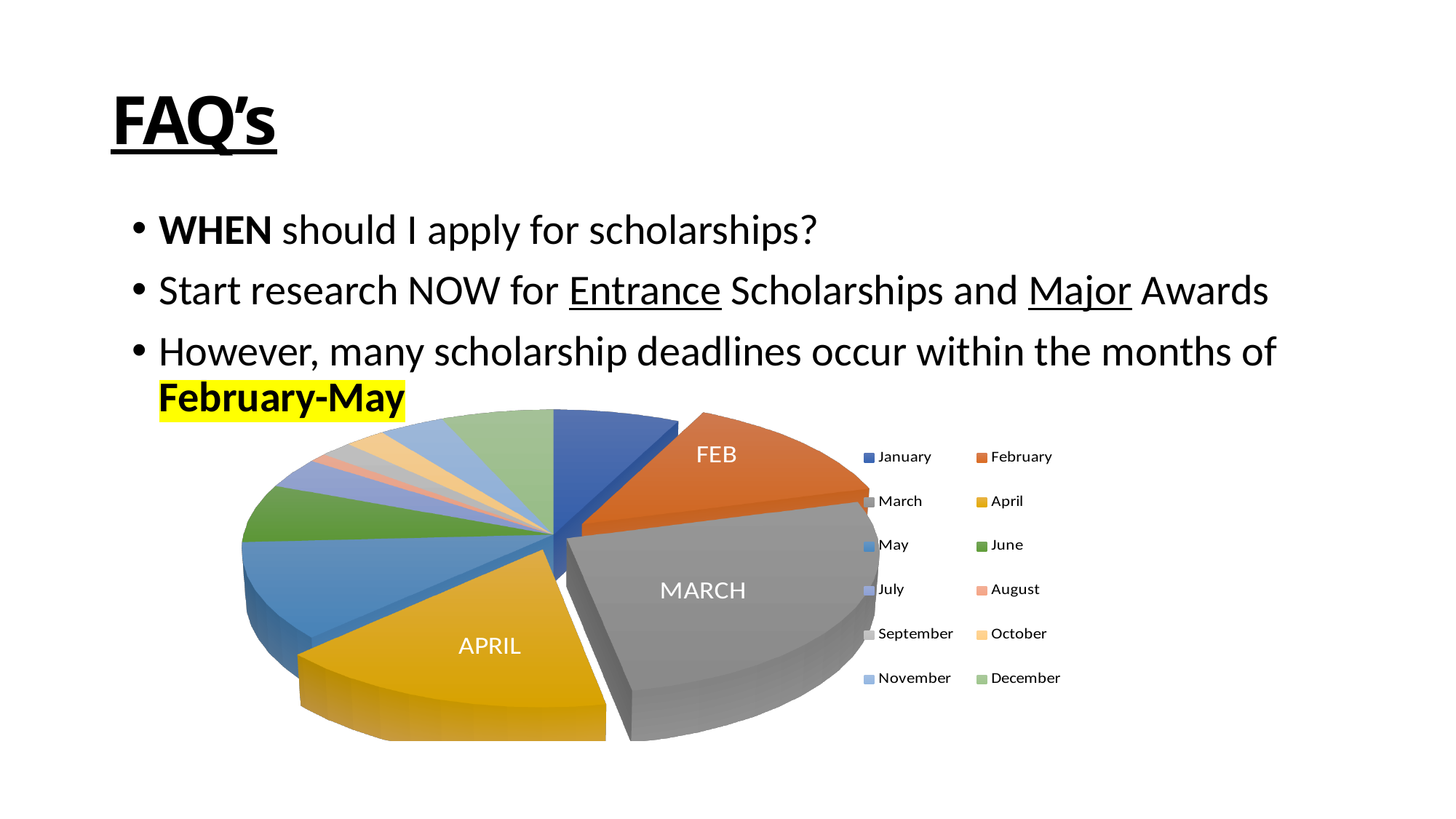
Which slice is larger in the pie chart, March or June? March Which slice is larger in the pie chart, April or August? April Which slice is larger in the pie chart, March or January? March How many categories does the pie chart's legend list? 12 What kind of chart is shown on the slide? Pie chart What colour is the March slice in the pie chart? Grey Which month has the largest slice in the pie chart? March Which three slices of the pie chart are pulled out from the rest and labelled directly on the chart? FEB, MARCH, APRIL